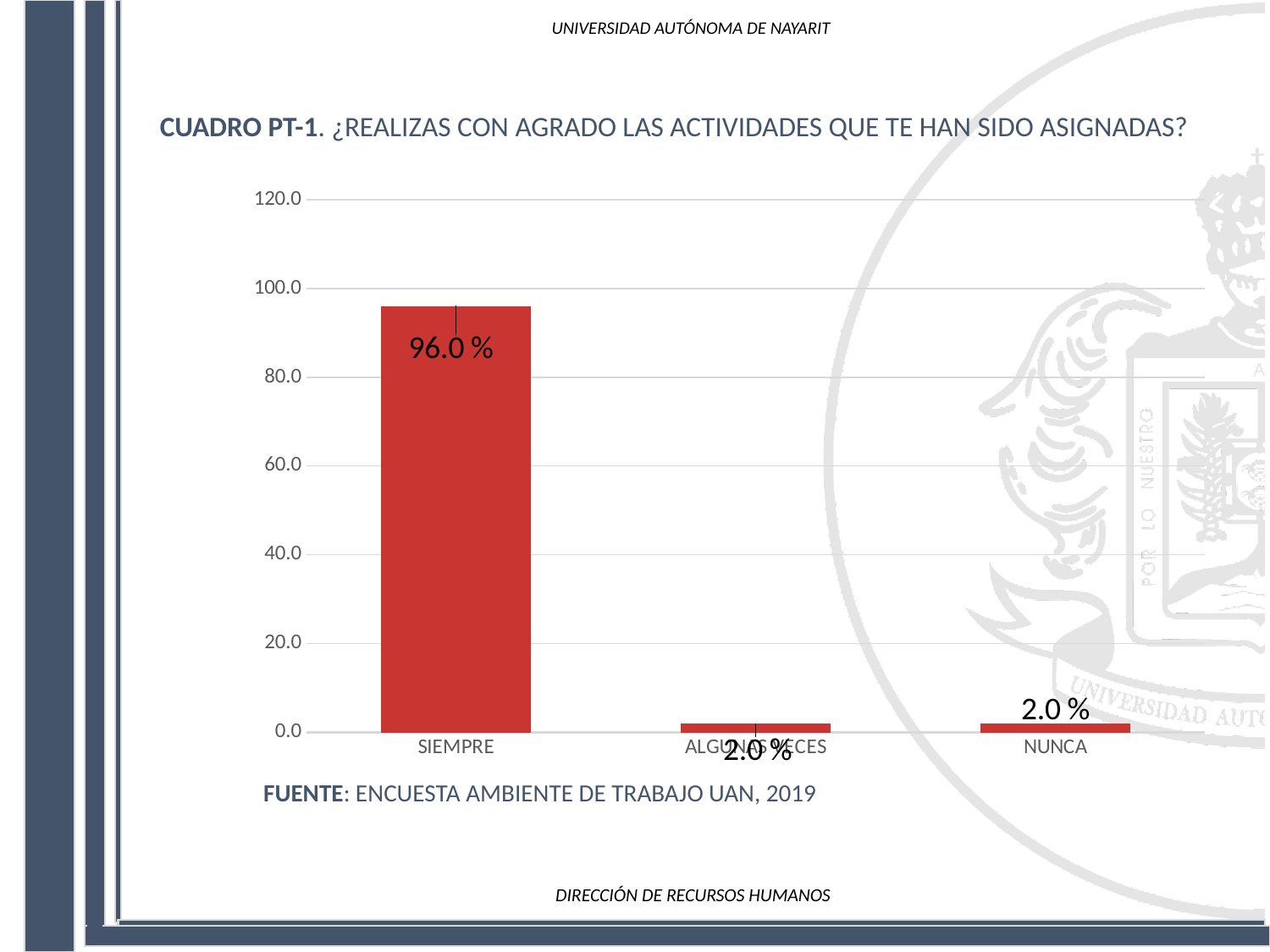
What kind of chart is shown on the slide? bar chart How many categories are shown on the x axis? 3 What is the title of the chart? CUADRO PT-1. ¿REALIZAS CON AGRADO LAS ACTIVIDADES QUE TE HAN SIDO ASIGNADAS? Is the value for SIEMPRE greater or less than 80.0? greater What is the value for NUNCA? 2.0 % What is the value of the middle bar in the chart? 2.0 % Which is larger, the value for SIEMPRE or the value for NUNCA? SIEMPRE What source is cited below the chart? ENCUESTA AMBIENTE DE TRABAJO UAN, 2019 Is the value for NUNCA greater or less than 20.0? less What is the difference between the values for SIEMPRE and NUNCA? 94.0 % What is the value for SIEMPRE? 96.0 % Which category has the highest value? SIEMPRE